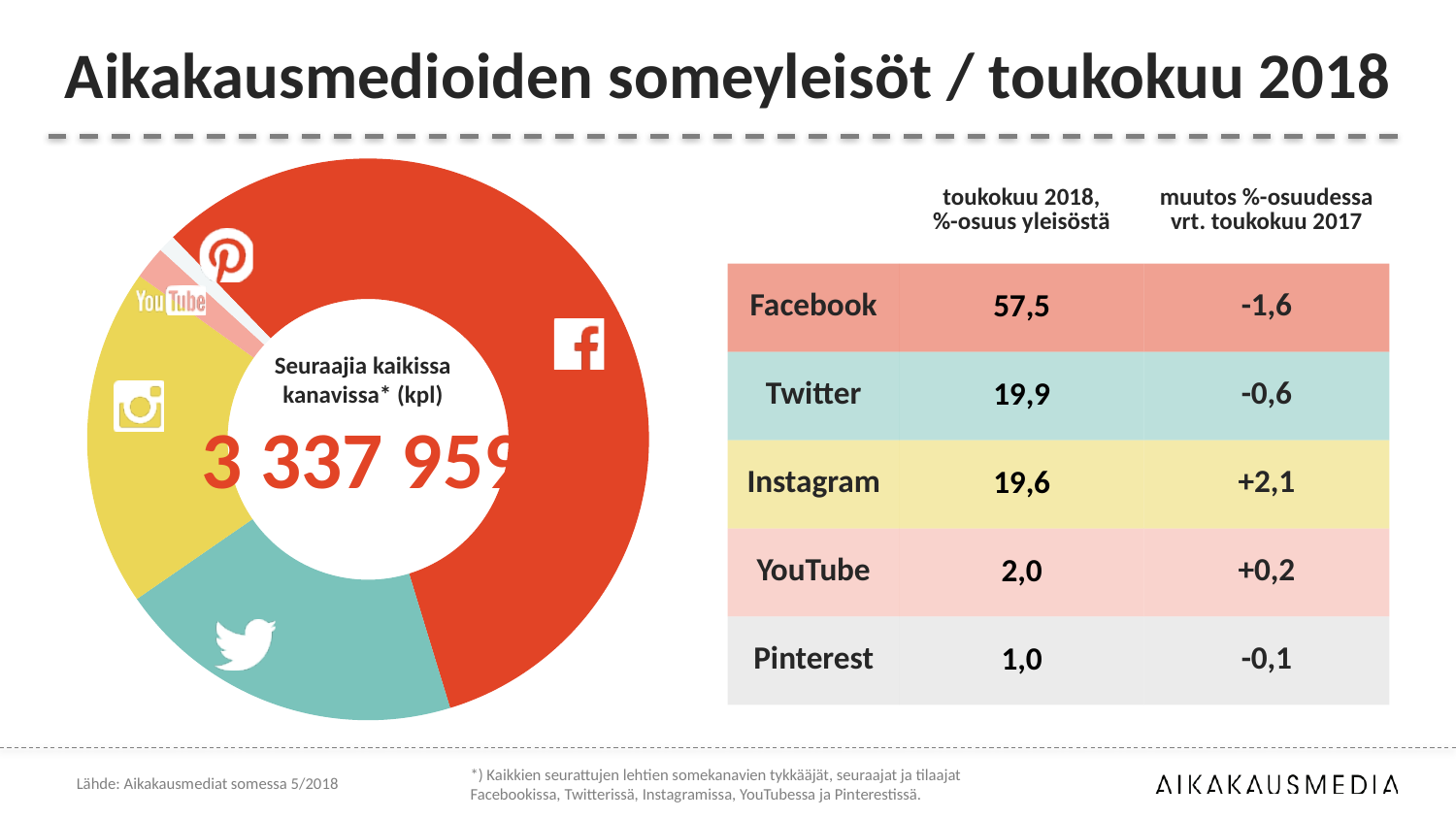
What is Instagram's share of the audience in May 2018? 19,6 Which channel has the smallest share of the audience in May 2018? Pinterest How many percentage points larger is Facebook's share than Twitter's share in May 2018? 37,6 What is the change in Instagram's percentage share compared with May 2017? +2,1 Which is larger in May 2018: Facebook's share or Twitter's share? Facebook What is the total number of followers across all channels shown in the centre of the donut chart? 3 337 959 What is YouTube's share of the audience in May 2018? 2,0 What kind of chart is shown on the left of the slide? Pie chart (donut) What is Facebook's share of the audience in May 2018 according to the table? 57,5 Which channel has the largest share of the audience in May 2018? Facebook How many social media channels are shown as slices in the donut chart? 5 What is the change in Facebook's percentage share compared with May 2017? -1,6